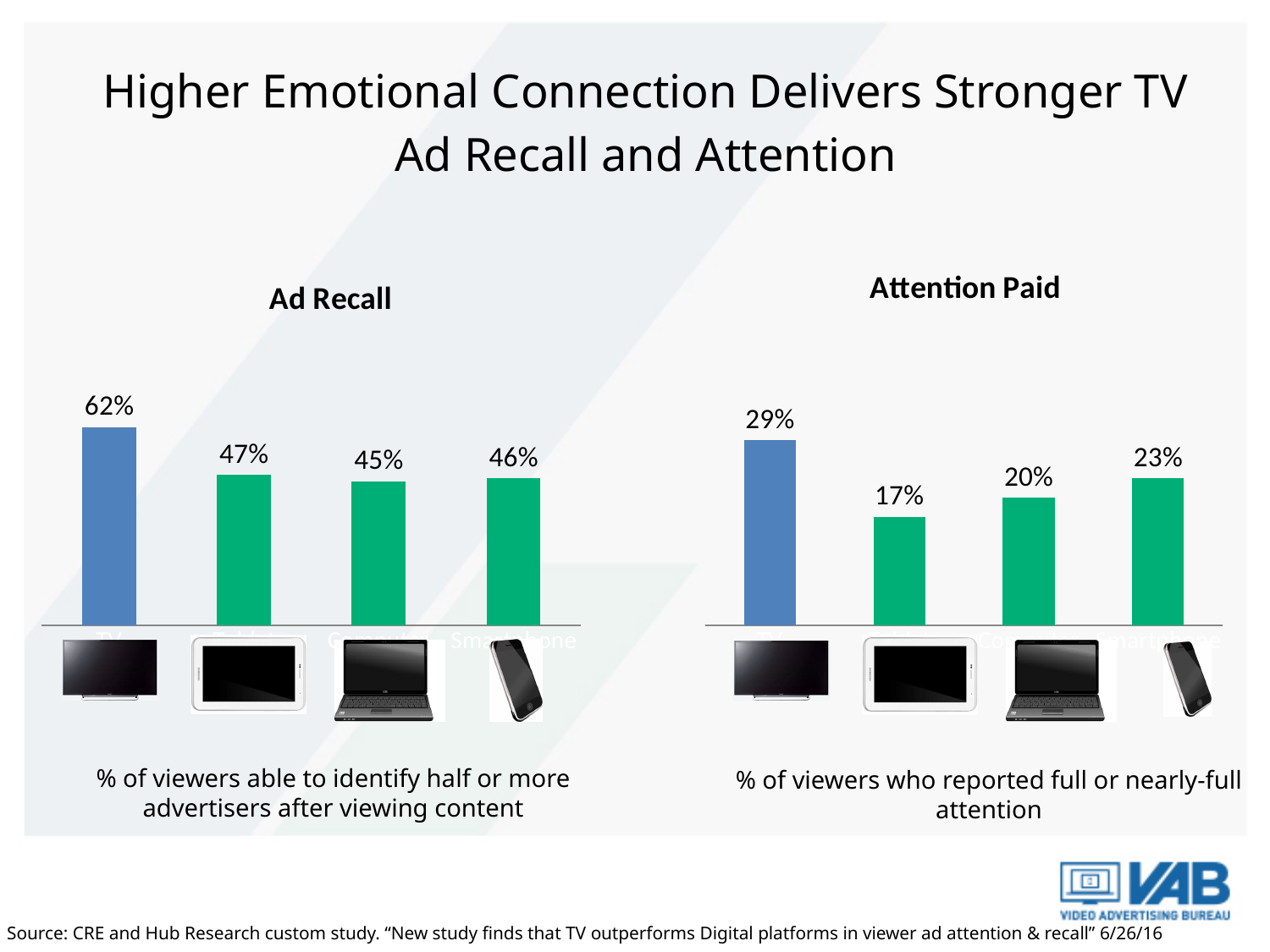
In the Ad Recall chart, what is the value for Computer? 45% What is the title of the chart on the left side of the slide? Ad Recall In the Ad Recall chart, which category has the highest value? TV In the Attention Paid chart, what is the value for Smartphone? 23% What type of chart is the Attention Paid chart? Bar chart In the Attention Paid chart, what is the value for Tablet? 17% In the Attention Paid chart, what is the difference between the TV value and the Computer value? 9% In the Attention Paid chart, which is larger, the value for Computer or the value for Smartphone? Smartphone In the Attention Paid chart, which category has the lowest value? Tablet How many categories are shown in the Ad Recall chart? 4 In the Ad Recall chart, what is the value for TV? 62% In the Ad Recall chart, what is the difference between the TV value and the Tablet value? 15%